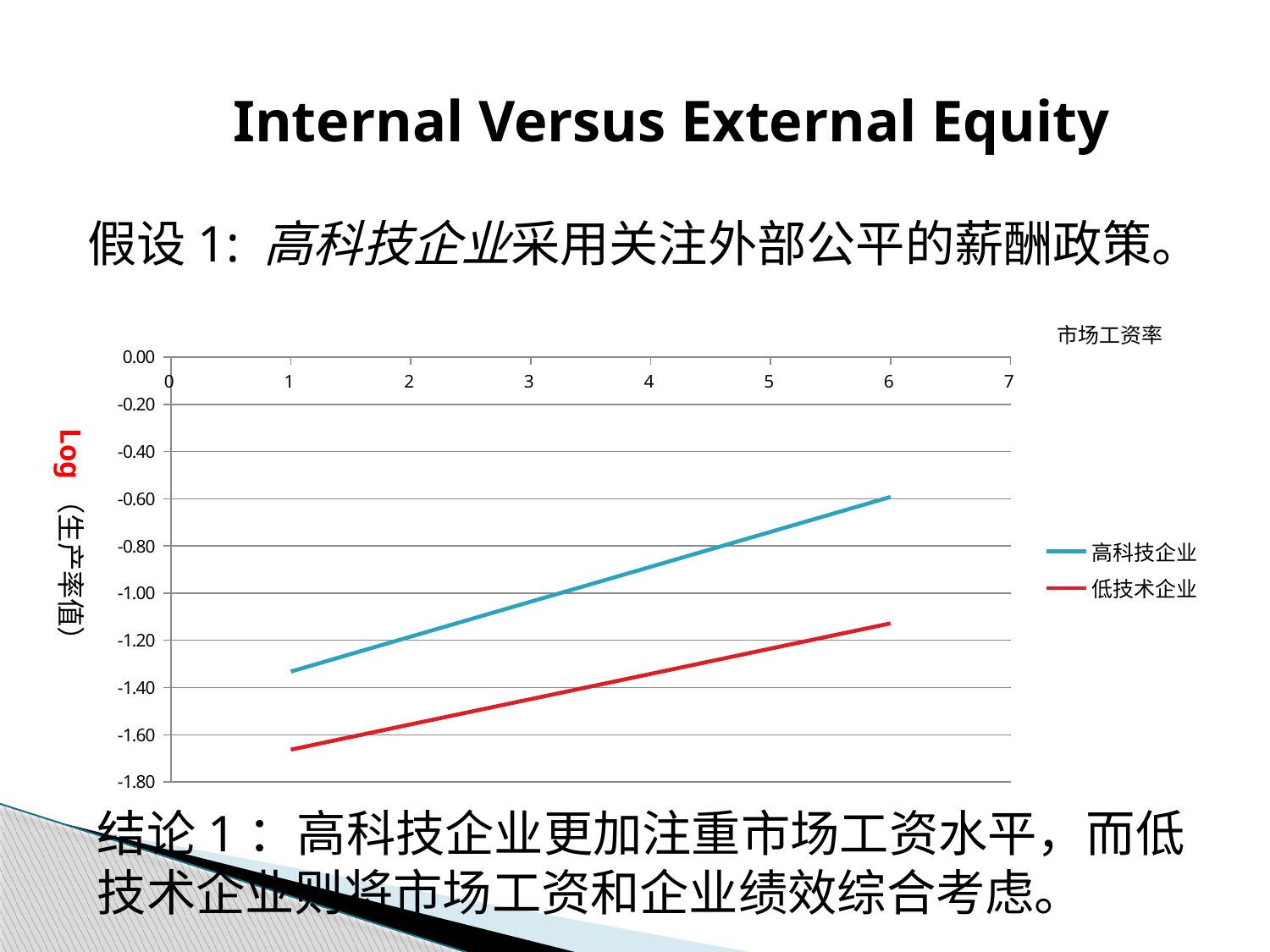
Do the values for 高科技企业 rise or fall as the x axis increases? rise Which two series are listed in the chart legend? 高科技企业 and 低技术企业 Do the values for 低技术企业 rise or fall as the x axis increases? rise What colour is the line for 高科技企业? blue Is the value for 低技术企业 at x = 1 greater or less than -1.40? less Is the value for 高科技企业 at x = 1 greater or less than -1.20? less What kind of chart is shown on the slide? line chart Is the value for 低技术企业 at x = 6 greater or less than -1.40? greater How many series does the chart legend list? 2 At x = 1, which series has the lower value, 高科技企业 or 低技术企业? 低技术企业 At x = 6, which series has the higher value, 高科技企业 or 低技术企业? 高科技企业